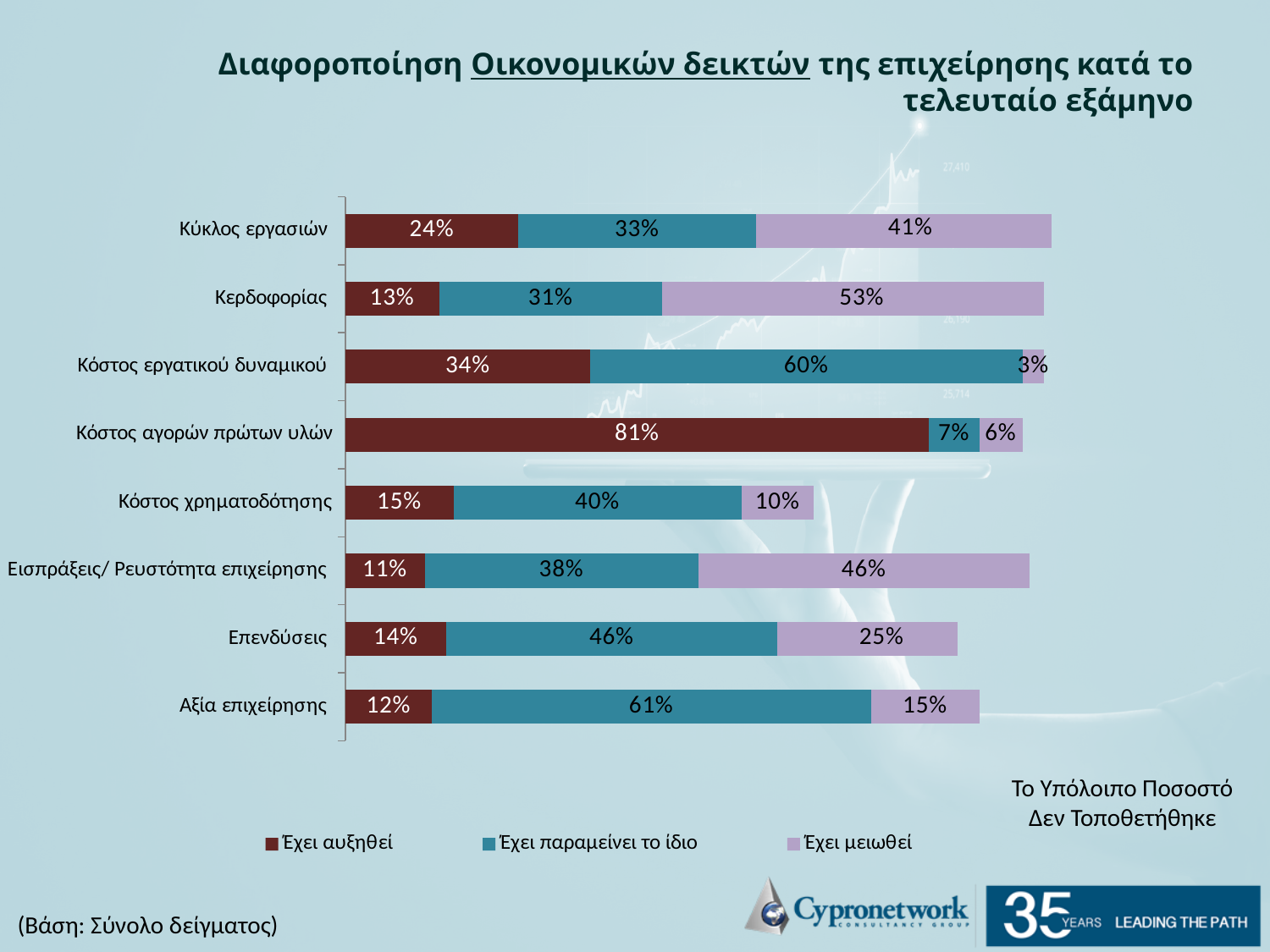
How many series does the legend list? 3 How many categories are shown on the chart? 8 Which category has the lowest value for 'Έχει μειωθεί'? Κόστος εργατικού δυναμικού Which category has the highest value for 'Έχει αυξηθεί'? Κόστος αγορών πρώτων υλών What is the value of 'Έχει αυξηθεί' for 'Κόστος αγορών πρώτων υλών'? 81% Which is larger: the 'Έχει αυξηθεί' value for 'Κύκλος εργασιών' or for 'Κερδοφορίας'? Κύκλος εργασιών What is the value of 'Έχει μειωθεί' for 'Κερδοφορίας'? 53% What is the value of 'Έχει παραμείνει το ίδιο' for 'Επενδύσεις'? 46% Which legend entry is shown in dark red? Έχει αυξηθεί What is the total of the stacked bar for 'Κόστος χρηματοδότησης'? 65% What type of chart is shown on the slide? Stacked bar chart What is the difference between the 'Έχει μειωθεί' values for 'Κερδοφορίας' and 'Κύκλος εργασιών'? 12%